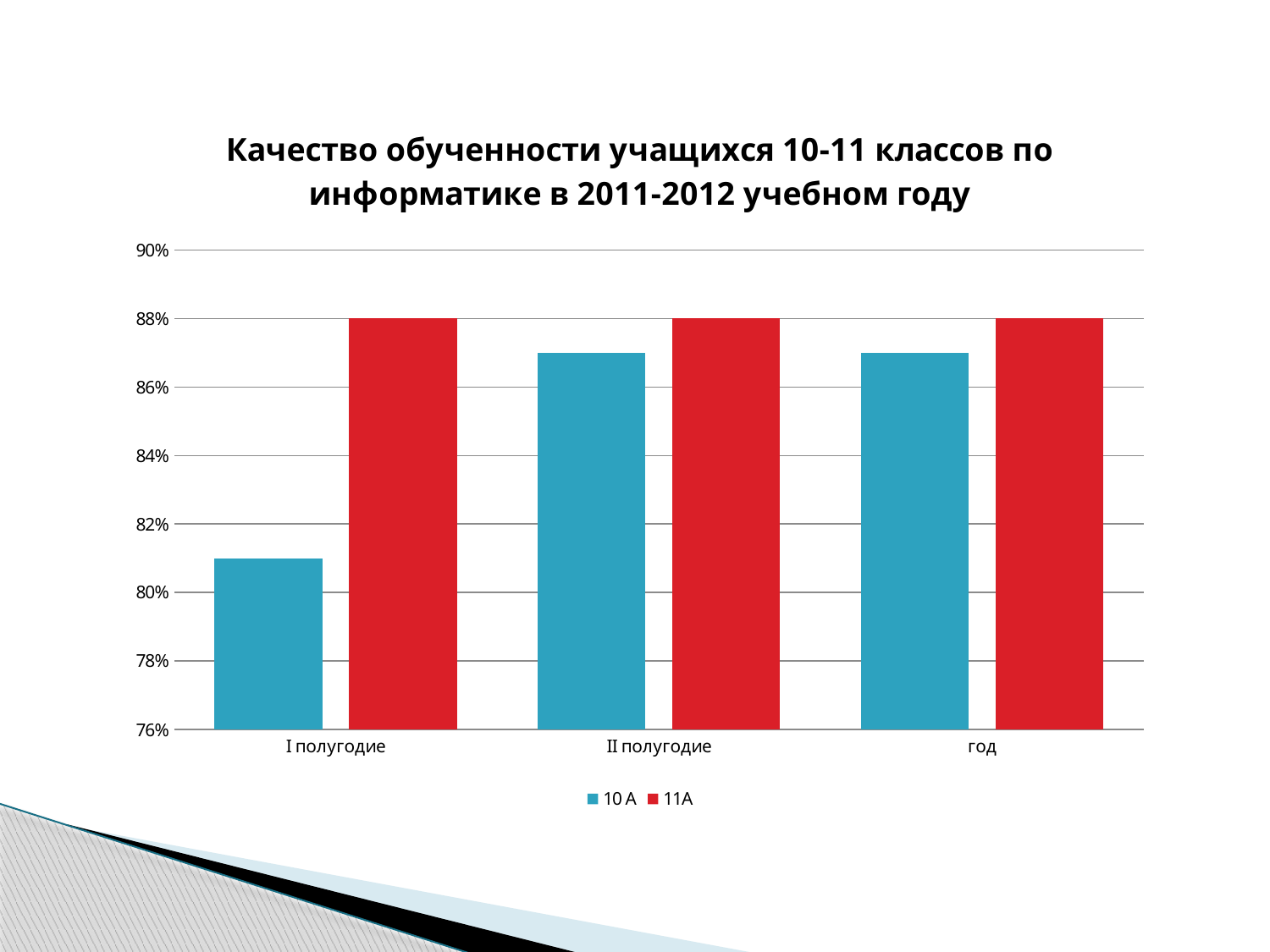
Which series has the larger value in I полугодие, 10 А or 11А? 11А What is the value for 11А in II полугодие? 88% What is the value for 11А for год? 88% Is the value for 10 А in I полугодие greater or less than 82%? less Does the value for 10 А rise or fall from I полугодие to II полугодие? rise Which colour represents the 11А series in the legend? red Is the value for 10 А for год greater or less than 88%? less How many series does the legend list? 2 Is the value for 10 А in II полугодие greater or less than 86%? greater What is the value for 11А in I полугодие? 88% What kind of chart is shown on the slide? bar chart How many categories are shown on the x axis? 3